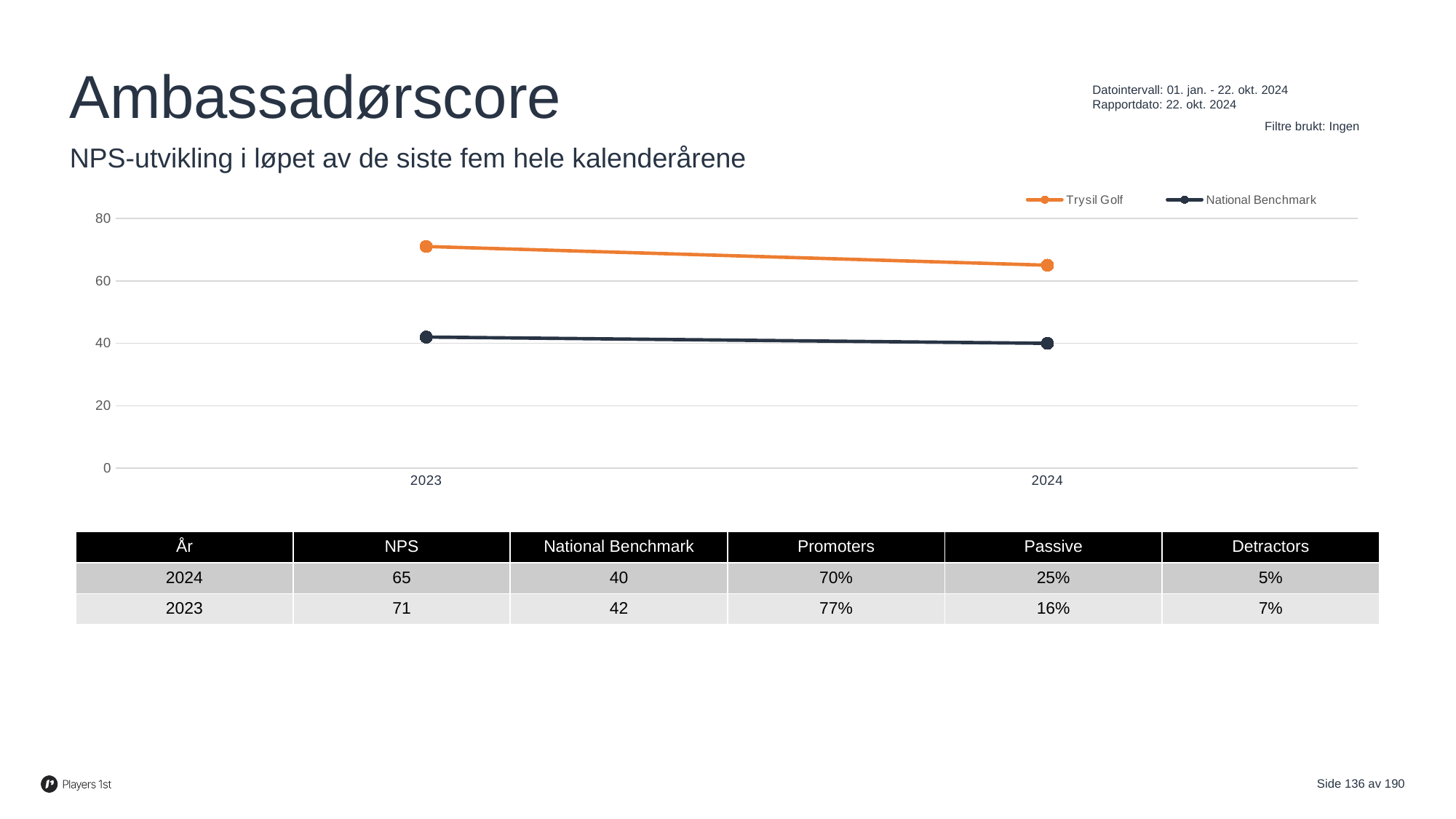
Does the Trysil Golf line rise or fall from 2023 to 2024? fall Which series is higher in 2024, Trysil Golf or National Benchmark? Trysil Golf What is the NPS value for Trysil Golf in 2023? 71 What is the NPS value for Trysil Golf in 2024? 65 What kind of chart is shown on the slide? line chart How many years are plotted on the x axis of the chart? 2 What is the National Benchmark value in 2024? 40 What is the National Benchmark value in 2023? 42 Is the Trysil Golf value for 2023 greater or less than 60? greater What is the difference between the Trysil Golf value and the National Benchmark value in 2024? 25 Which colour is used for the Trysil Golf line in the chart? orange How many series does the chart legend list? 2